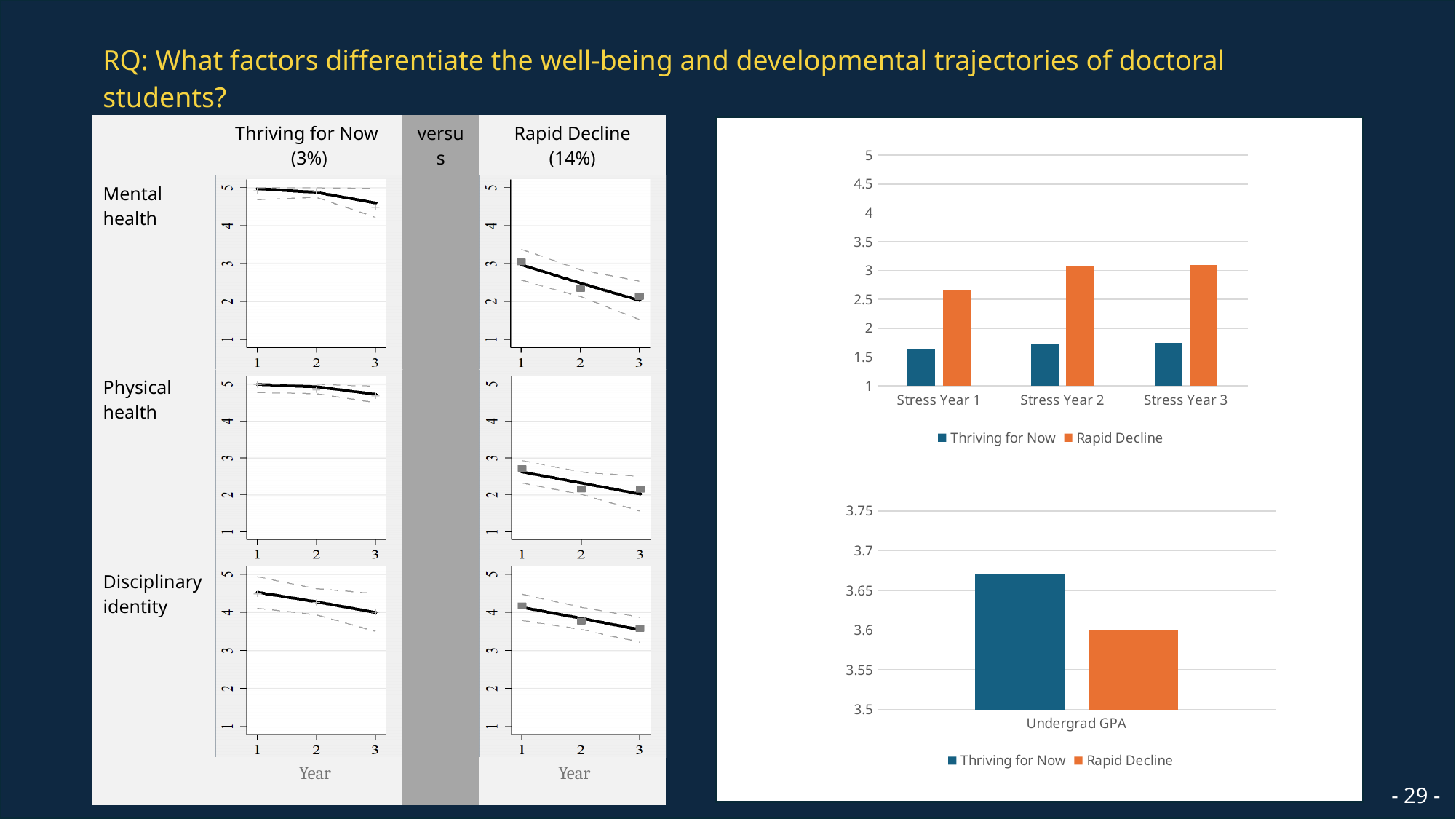
In the upper right stress chart, how many categories are shown on the x axis? 3 In the right-hand bar charts, what colour represents the Rapid Decline series? orange In the upper right stress chart, which category has the lowest Rapid Decline value? Stress Year 1 In the upper right stress chart, is the Rapid Decline value for Stress Year 3 greater or less than 3.5? less In the lower right Undergrad GPA chart, which series has the larger value, Thriving for Now or Rapid Decline? Thriving for Now In the upper right stress chart, is the Rapid Decline value for Stress Year 1 greater or less than 2.5? greater What kind of chart is the upper chart on the right (Stress Year 1 to Stress Year 3)? bar chart In the upper right stress chart, which series has the larger value for Stress Year 2, Thriving for Now or Rapid Decline? Rapid Decline In the upper right stress chart, how many series does the legend list? 2 In the lower right Undergrad GPA chart, is the Thriving for Now value greater or less than 3.65? greater In the upper right stress chart, do the Rapid Decline values rise or fall from Stress Year 1 to Stress Year 3? rise